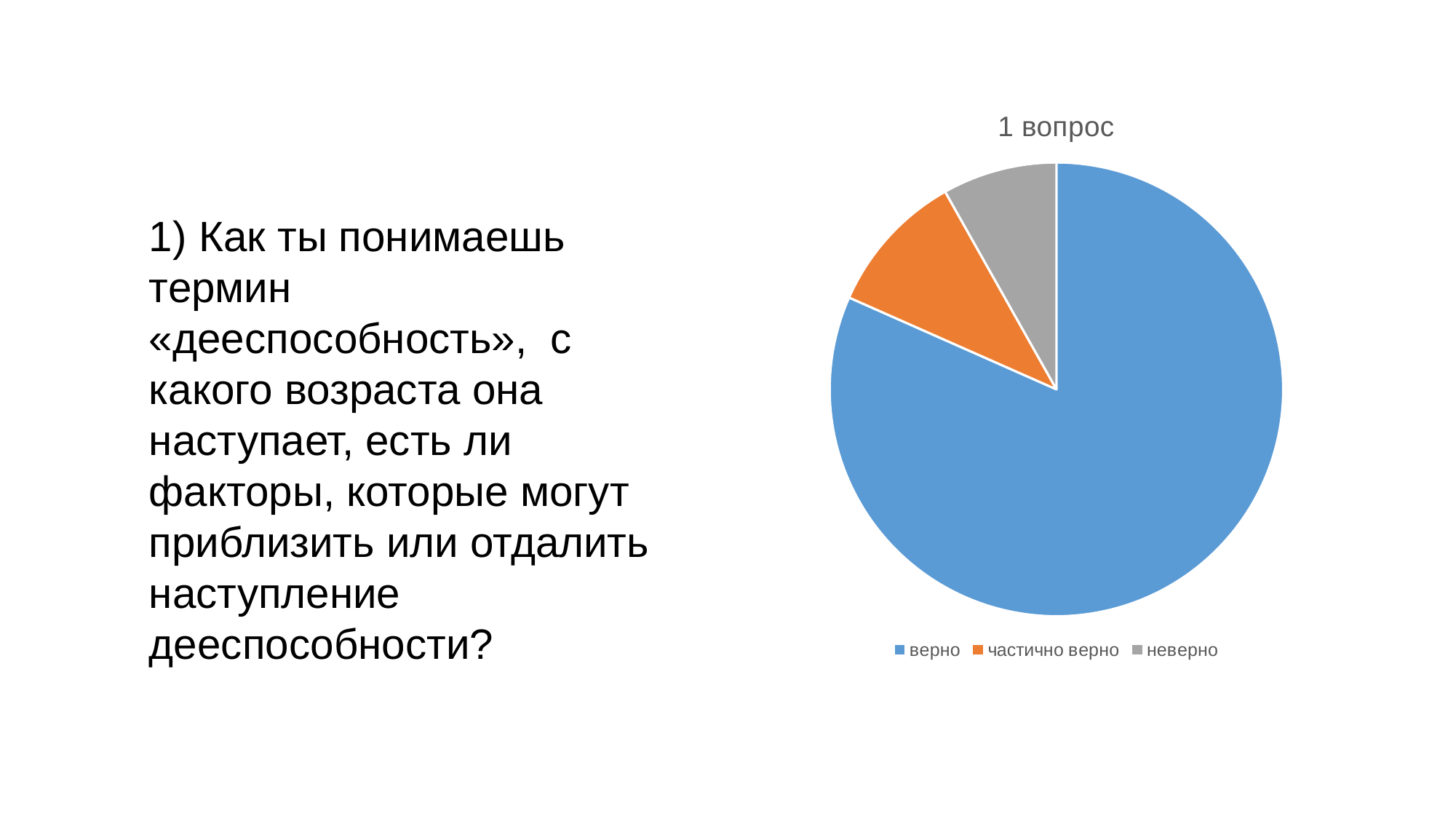
Which category has the largest slice of the pie? верно What is the title of the chart? 1 вопрос What kind of chart is shown on the slide? pie chart How many entries does the chart legend list? 3 Which slice is larger, частично верно or неверно? частично верно What colour is the slice for верно? blue Which slice is larger, верно or частично верно? верно Which category has the smallest slice of the pie? неверно Does the верно slice take up more or less than half of the pie? more How many slices does the pie chart have? 3